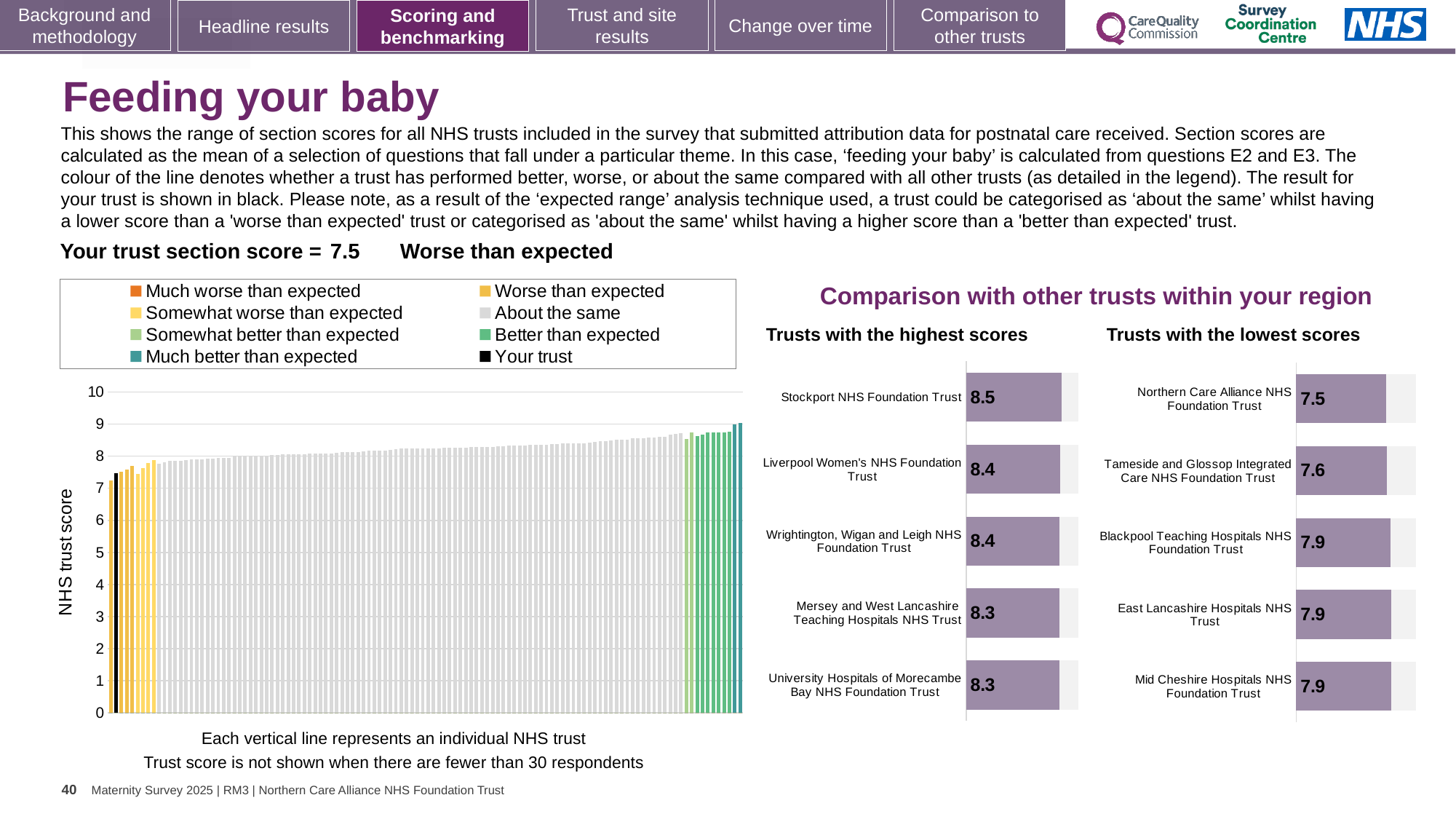
How many entries does the legend above the 'NHS trust score' chart list? 8 In the 'Trusts with the highest scores' chart, which trust has the highest score? Stockport NHS Foundation Trust In the 'Trusts with the lowest scores' chart, what is the score for Tameside and Glossop Integrated Care NHS Foundation Trust? 7.6 In the 'Trusts with the highest scores' chart, which has the larger score: Liverpool Women's NHS Foundation Trust or Mersey and West Lancashire Teaching Hospitals NHS Trust? Liverpool Women's NHS Foundation Trust How many trusts are listed in the 'Trusts with the highest scores' chart? 5 In the 'Trusts with the lowest scores' chart, which trust has the lowest score? Northern Care Alliance NHS Foundation Trust In the 'Trusts with the lowest scores' chart, what is the difference between the scores of Blackpool Teaching Hospitals NHS Foundation Trust and Northern Care Alliance NHS Foundation Trust? 0.4 What kind of chart is the 'NHS trust score' chart on the left of the slide? Bar chart In the 'NHS trust score' chart on the left, do the bar values rise or fall from left to right? Rise In the 'Trusts with the highest scores' chart, what is the score for Stockport NHS Foundation Trust? 8.5 In the 'NHS trust score' chart on the left, what is the section score for your trust (the black bar)? 7.5 In the 'NHS trust score' chart on the left, is the value of the black 'Your trust' bar greater or less than 8? less